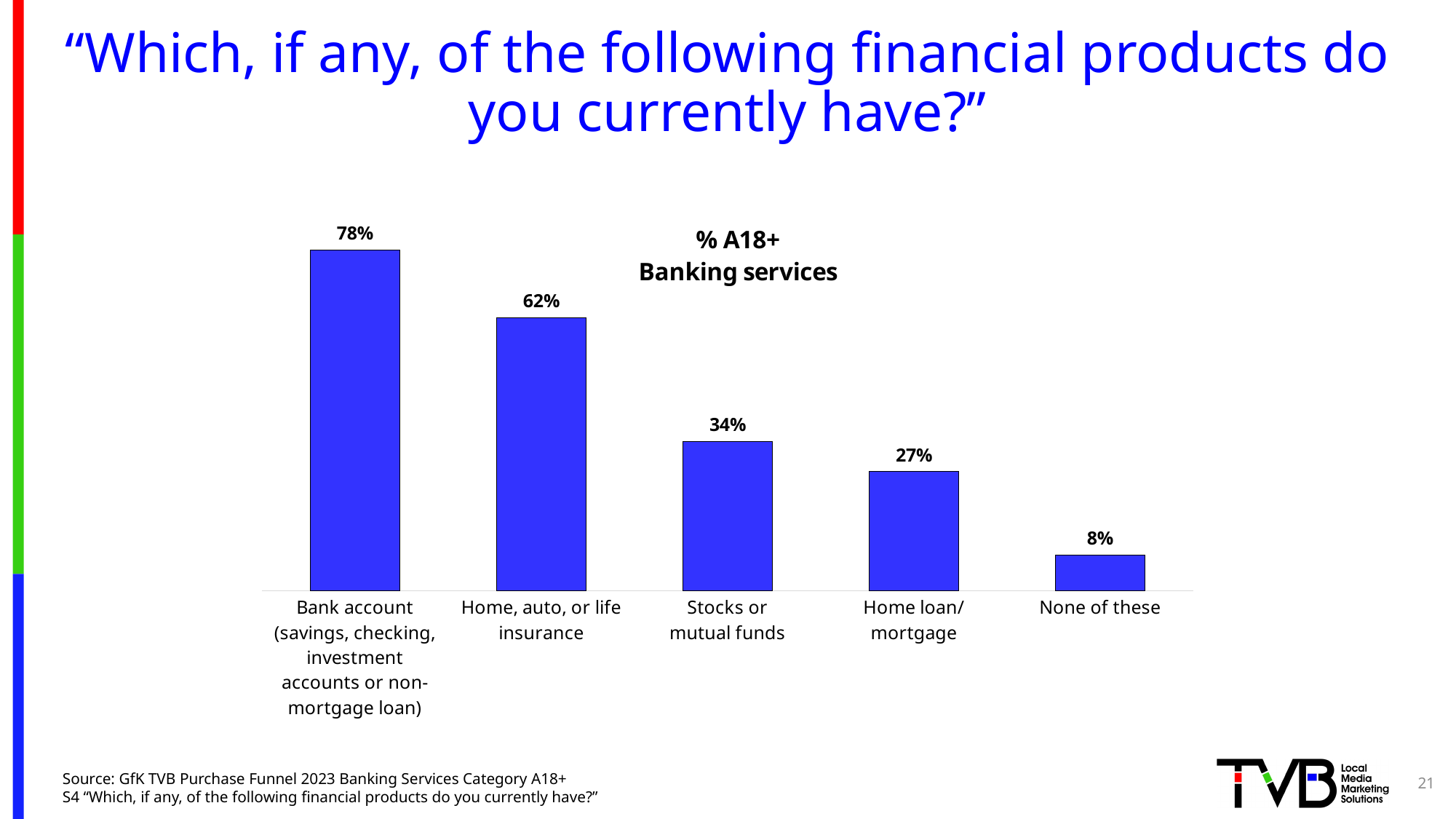
What percentage of adults 18+ currently have home, auto, or life insurance? 62% What is the value shown for Home loan/mortgage? 27% What percentage of adults 18+ currently have a bank account (savings, checking, investment accounts or non-mortgage loan)? 78% Which is larger, the value for Home loan/mortgage or the value for Stocks or mutual funds? Stocks or mutual funds What percentage of respondents selected None of these? 8% What type of chart is shown on the slide? Bar chart What is the difference in percentage points between Stocks or mutual funds and Home loan/mortgage? 7 What is the value shown for Stocks or mutual funds? 34% How many categories are shown in the bar chart? 5 Which category has the lowest percentage in the chart? None of these What is the difference in percentage points between Bank account and Home, auto, or life insurance? 16 Which financial product has the highest percentage in the chart? Bank account (savings, checking, investment accounts or non-mortgage loan)